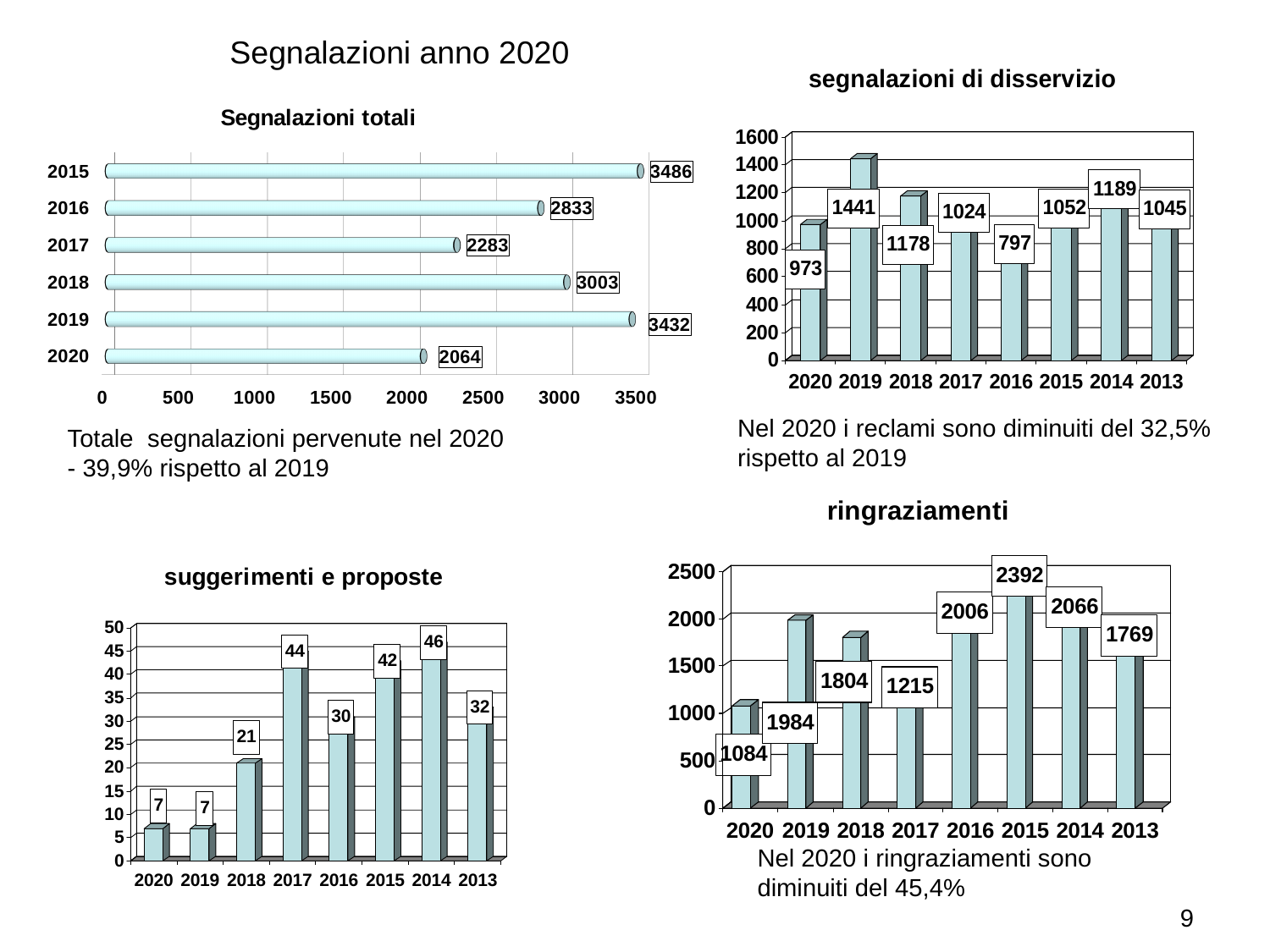
What kind of chart is "Segnalazioni totali"? bar chart In the "suggerimenti e proposte" chart, which year has the highest value? 2014 In the "segnalazioni di disservizio" chart, which year has the lowest value? 2016 In the "suggerimenti e proposte" chart, what is the value for 2018? 21 In the "Segnalazioni totali" chart, what is the value for 2020? 2064 In the "segnalazioni di disservizio" chart, what is the value for 2019? 1441 In the "ringraziamenti" chart, which is larger, the value for 2018 or the value for 2017? 2018 In the "ringraziamenti" chart, what is the difference between the values for 2019 and 2020? 900 In the "Segnalazioni totali" chart, which year has the highest value? 2015 In the "ringraziamenti" chart, what is the value for 2015? 2392 How many years are shown in the "segnalazioni di disservizio" chart? 8 In the "Segnalazioni totali" chart, what is the difference between the values for 2019 and 2020? 1368